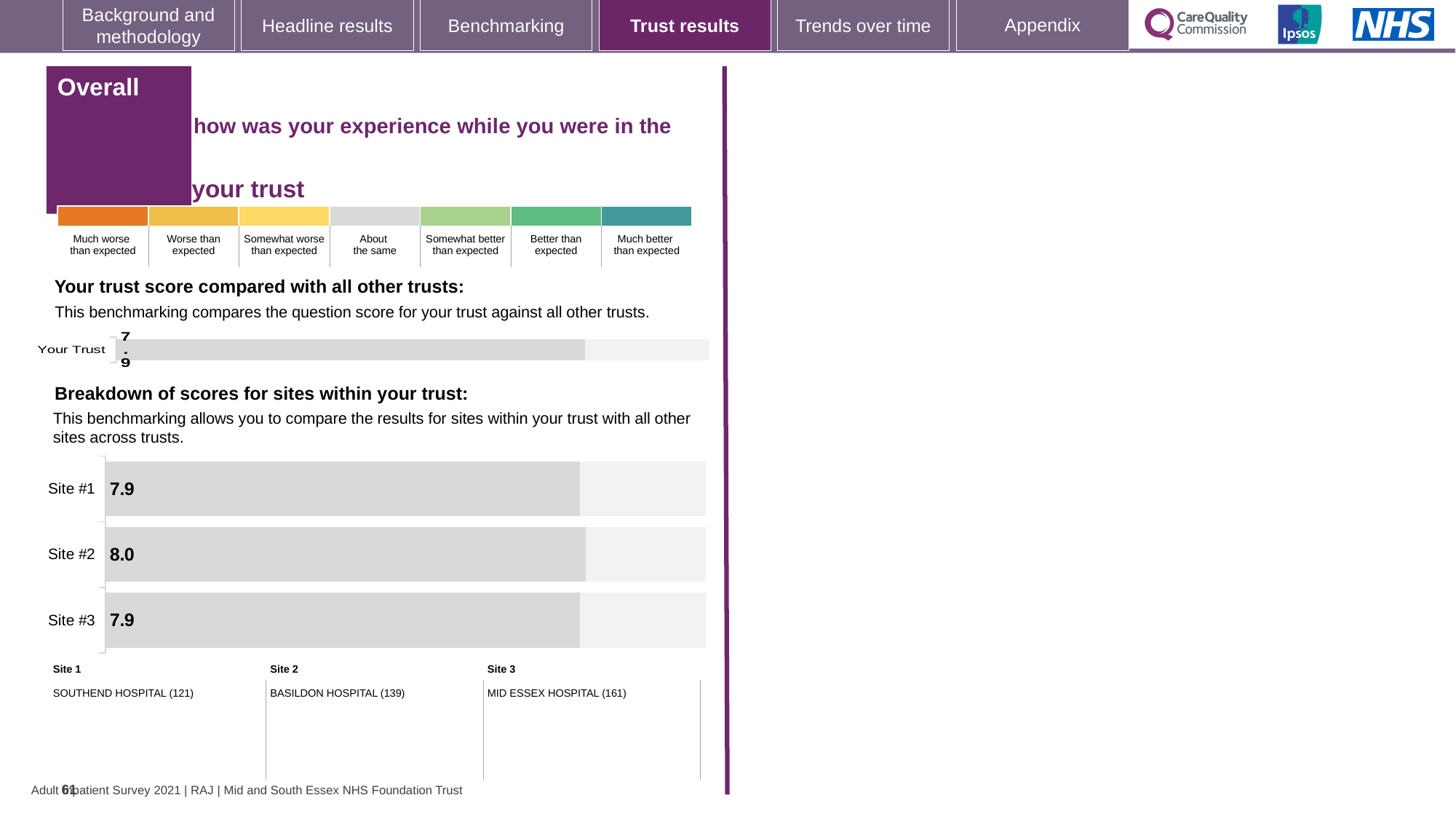
In the 'Breakdown of scores for sites within your trust' chart, what is the score for Site #3? 7.9 In the 'Breakdown of scores for sites within your trust' chart, what is the difference between the scores for Site #2 and Site #1? 0.1 What kind of chart is the 'Breakdown of scores for sites within your trust' chart? Bar chart How many categories are plotted in the 'Your trust score compared with all other trusts' chart? 1 In the 'Breakdown of scores for sites within your trust' chart, which has the larger score, Site #2 or Site #3? Site #2 In the 'Breakdown of scores for sites within your trust' chart, which site has the highest score? Site #2 According to the site key below the breakdown chart, which hospital is Site 2? BASILDON HOSPITAL (139) According to the site key below the breakdown chart, which hospital is Site 3? MID ESSEX HOSPITAL (161) In the 'Breakdown of scores for sites within your trust' chart, what is the score for Site #1? 7.9 How many sites are shown in the 'Breakdown of scores for sites within your trust' chart? 3 In the 'Your trust score compared with all other trusts' chart, what is the score for Your Trust? 7.9 In the 'Breakdown of scores for sites within your trust' chart, what is the score for Site #2? 8.0